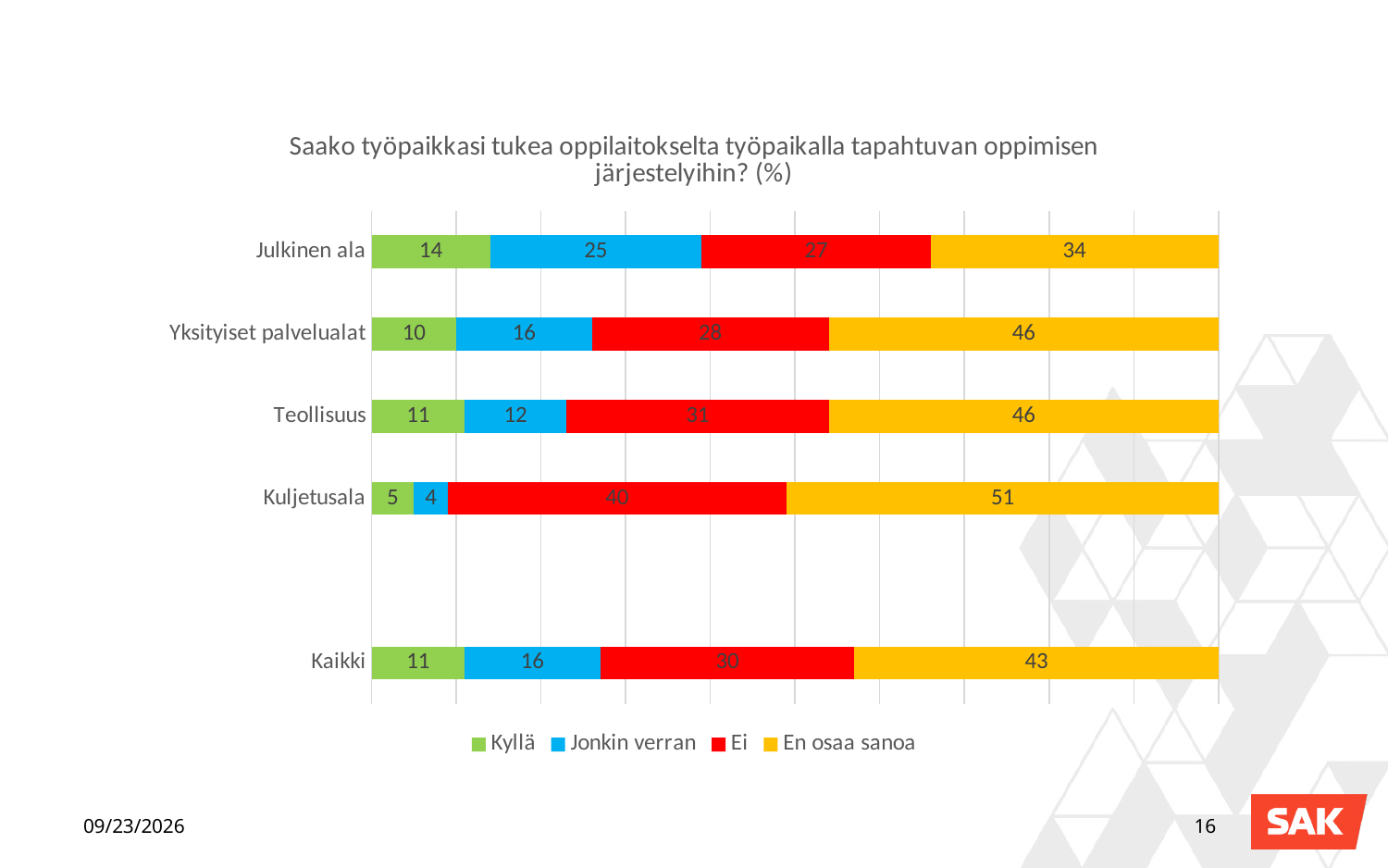
How many categories are shown on the vertical axis? 5 What is the value for "Kyllä" in the Julkinen ala bar? 14 What is the value for "En osaa sanoa" in the Kuljetusala bar? 51 What is the difference between the "En osaa sanoa" values for Kuljetusala and Julkinen ala? 17 Which category has the highest value for "Ei"? Kuljetusala What kind of chart is shown on the slide? Stacked bar chart Which is larger: the "Jonkin verran" value for Julkinen ala or for Teollisuus? Julkinen ala What is the value for "Jonkin verran" in the Kaikki bar? 16 What is the value for "Ei" in the Teollisuus bar? 31 Which category has the lowest value for "Kyllä"? Kuljetusala How many series does the legend list? 4 What is the total of the Kaikki bar? 100